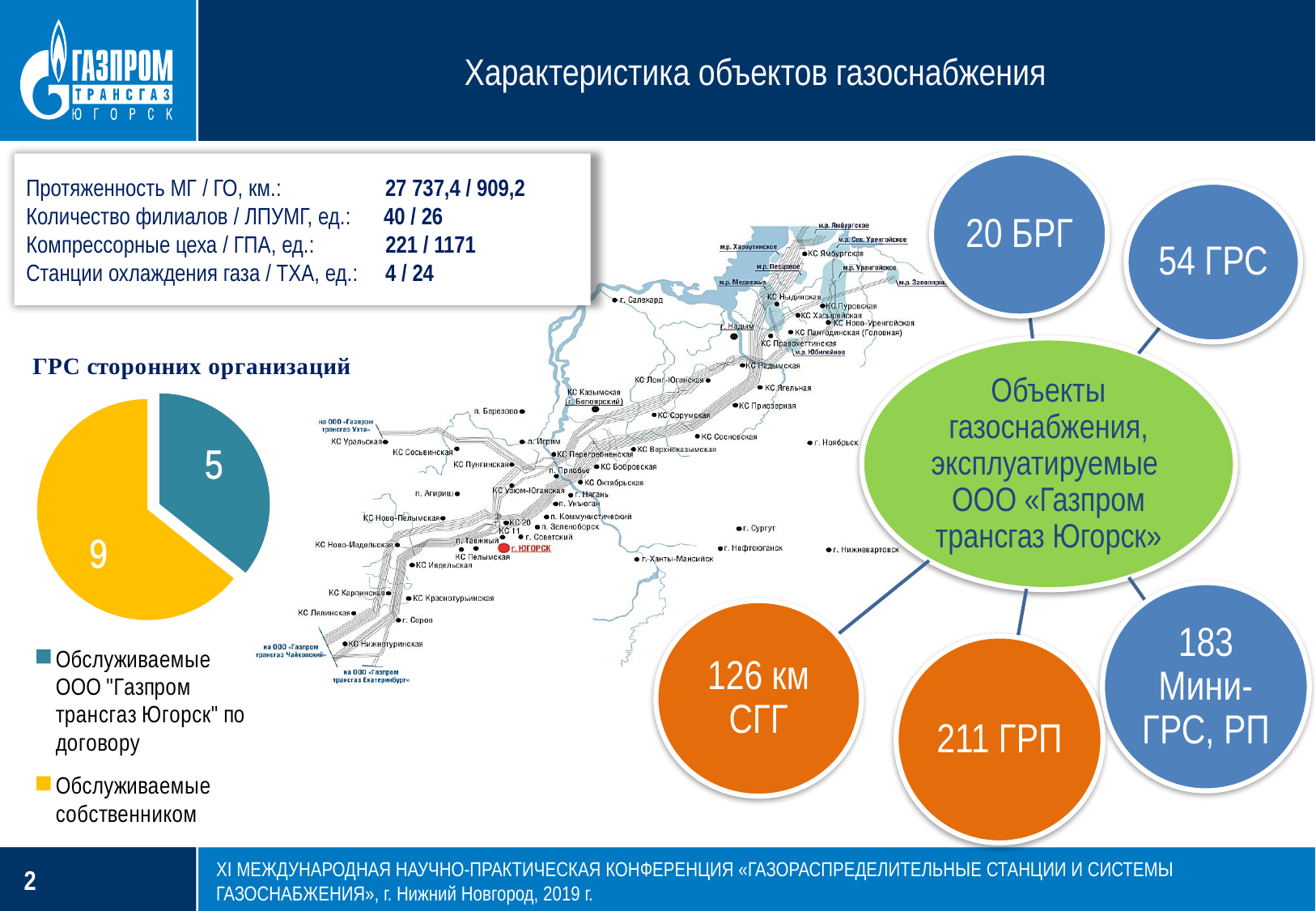
What type of chart is shown under the title "ГРС сторонних организаций"? pie chart What is the title of the pie chart on the slide? ГРС сторонних организаций How many entries does the legend of the pie chart "ГРС сторонних организаций" list? 2 In the pie chart "ГРС сторонних организаций", what is the value for "Обслуживаемые ООО "Газпром трансгаз Югорск" по договору"? 5 In the pie chart "ГРС сторонних организаций", which category has the smallest slice? Обслуживаемые ООО "Газпром трансгаз Югорск" по договору In the pie chart "ГРС сторонних организаций", what is the value for "Обслуживаемые собственником"? 9 What is the total of the two values shown in the pie chart "ГРС сторонних организаций"? 14 In the pie chart "ГРС сторонних организаций", what colour is the slice for "Обслуживаемые собственником"? yellow In the pie chart "ГРС сторонних организаций", which is larger: the value for "Обслуживаемые собственником" or the value for "Обслуживаемые ООО "Газпром трансгаз Югорск" по договору"? Обслуживаемые собственником How many slices does the pie chart "ГРС сторонних организаций" have? 2 In the pie chart "ГРС сторонних организаций", which category has the largest slice? Обслуживаемые собственником In the pie chart "ГРС сторонних организаций", what is the difference between the value for "Обслуживаемые собственником" and the value for "Обслуживаемые ООО "Газпром трансгаз Югорск" по договору"? 4